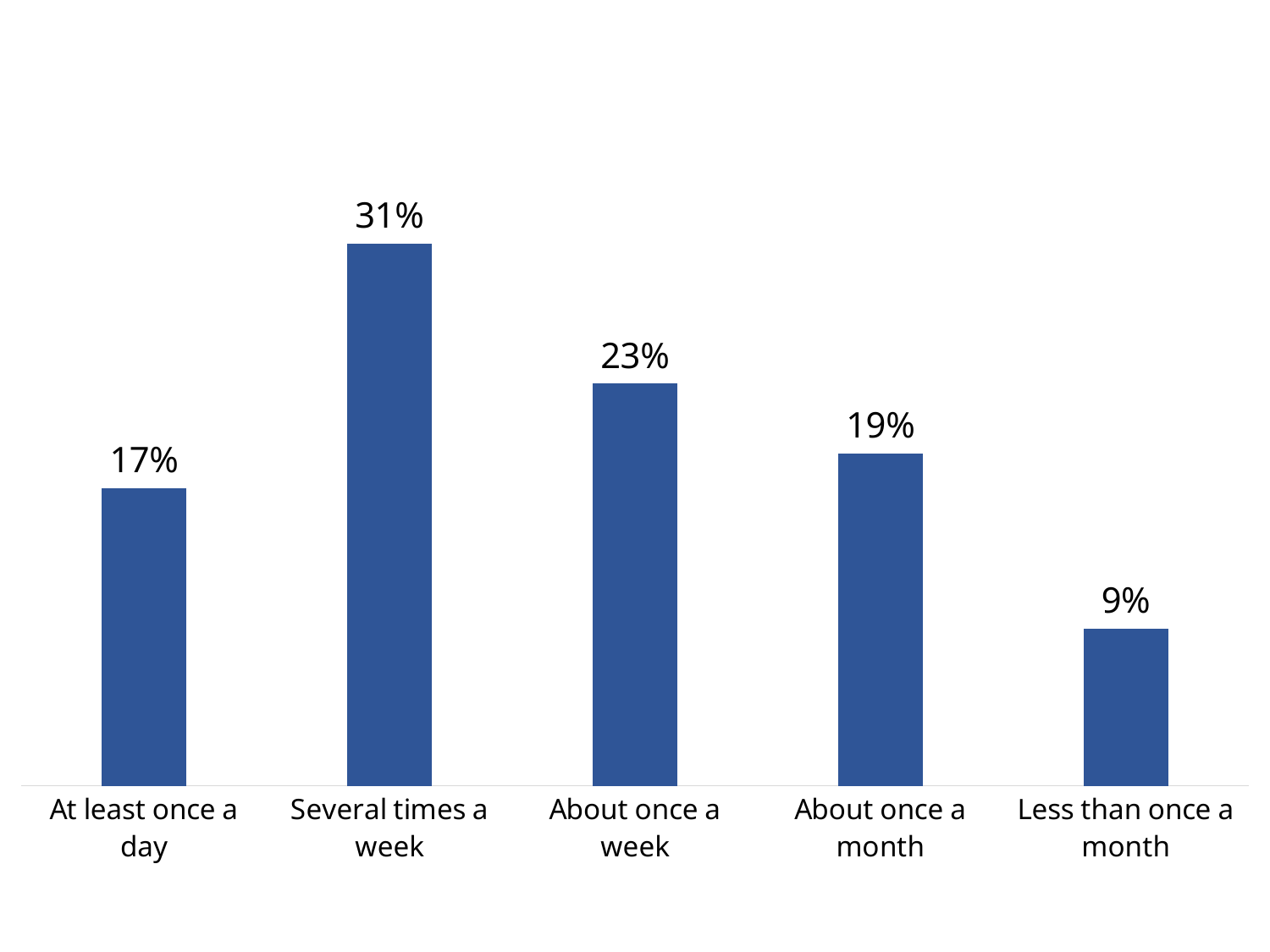
How many categories are shown in the chart? 5 What colour are the bars in the chart? Blue Which is larger, the value for "About once a week" or the value for "At least once a day"? About once a week What kind of chart is shown on the slide? Bar chart Which category has the lowest value? Less than once a month What is the difference between the values for "Several times a week" and "About once a week"? 8% Which category has the highest value? Several times a week What is the value for "At least once a day"? 17% What is the value for "Less than once a month"? 9% What is the value for "About once a month"? 19% What is the value for "Several times a week"? 31% What is the difference between the values for "About once a month" and "Less than once a month"? 10%